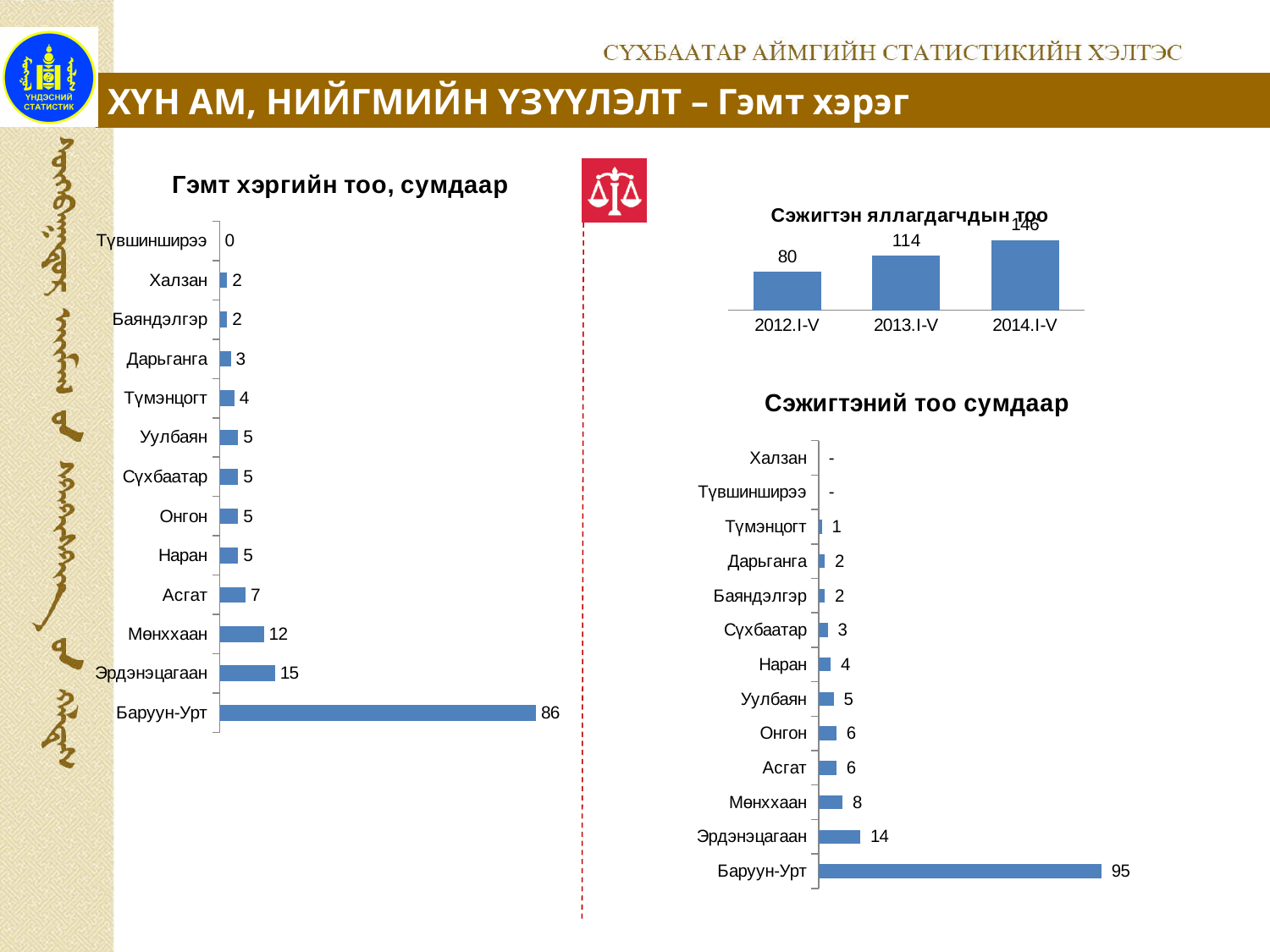
In the chart titled "Сэжигтэний тоо сумдаар", which category has the highest value? Баруун-Урт In the chart titled "Гэмт хэргийн тоо, сумдаар", how many categories are shown? 13 In the chart titled "Сэжигтэний тоо сумдаар", what is the value for Эрдэнэцагаан? 14 In the chart titled "Гэмт хэргийн тоо, сумдаар", which category has the lowest value? Түвшинширээ In the chart titled "Сэжигтэний тоо сумдаар", which is larger, Мөнххаан or Наран? Мөнххаан What kind of chart is "Сэжигтэн яллагдагчдын тоо"? bar chart In the chart titled "Гэмт хэргийн тоо, сумдаар", what is the value for Баруун-Урт? 86 In the chart titled "Гэмт хэргийн тоо, сумдаар", what is the value for Мөнххаан? 12 In the chart titled "Сэжигтэн яллагдагчдын тоо", what is the difference between 2014.I-V and 2012.I-V? 66 In the chart titled "Сэжигтэн яллагдагчдын тоо", do the values rise or fall from 2012.I-V to 2014.I-V? rise In the chart titled "Сэжигтэн яллагдагчдын тоо", what is the value for 2013.I-V? 114 In the chart titled "Гэмт хэргийн тоо, сумдаар", what is the difference between Баруун-Урт and Эрдэнэцагаан? 71